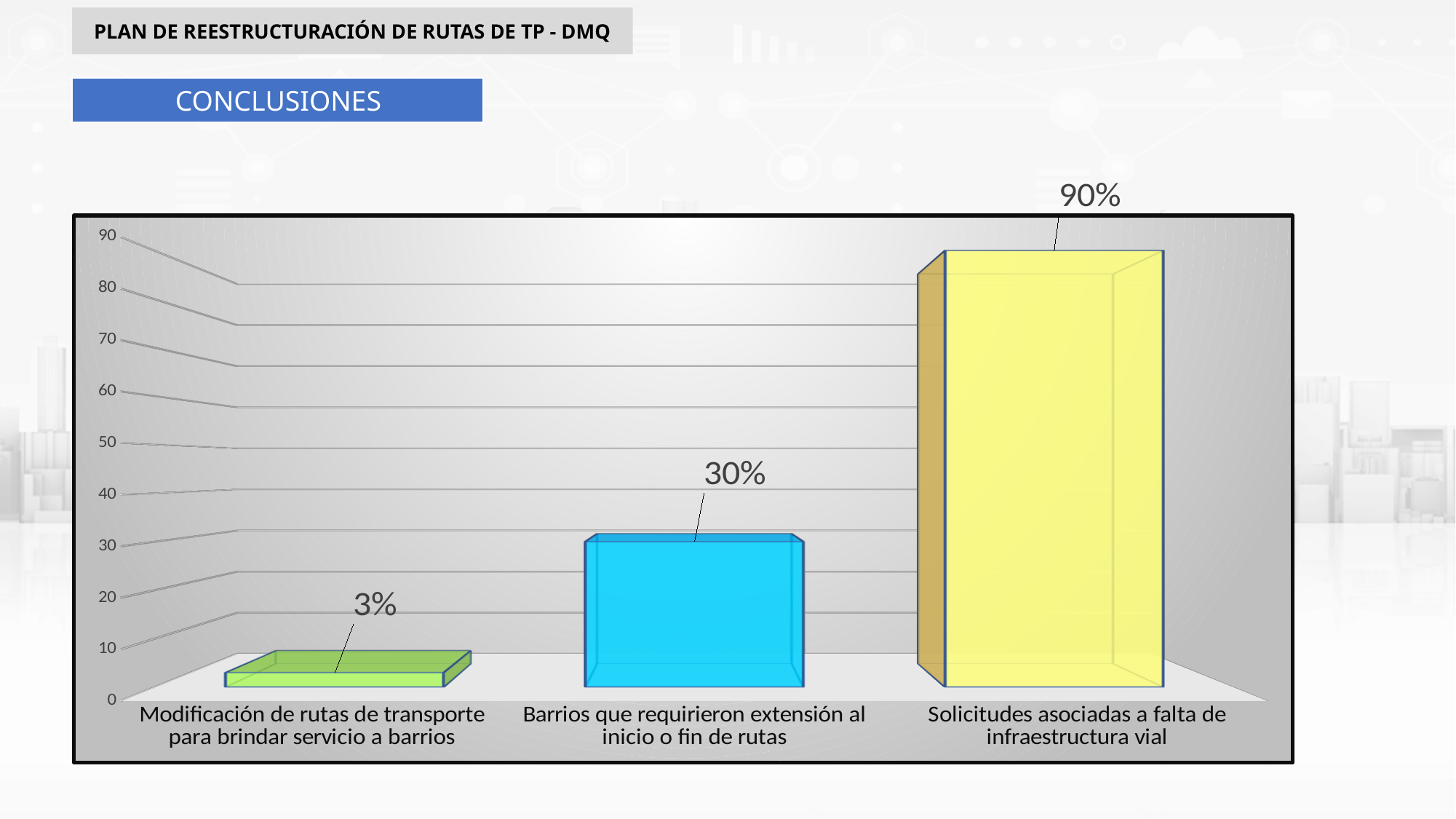
What is the difference between the values for "Solicitudes asociadas a falta de infraestructura vial" and "Barrios que requirieron extensión al inicio o fin de rutas"? 60% What is the difference between the values for "Barrios que requirieron extensión al inicio o fin de rutas" and "Modificación de rutas de transporte para brindar servicio a barrios"? 27% How many categories are shown in the chart? 3 What colour is the bar for "Solicitudes asociadas a falta de infraestructura vial"? Yellow What is the value for "Modificación de rutas de transporte para brindar servicio a barrios"? 3% Is the value for "Solicitudes asociadas a falta de infraestructura vial" greater or less than 50? greater What is the value for "Solicitudes asociadas a falta de infraestructura vial"? 90% Which category has the highest value? Solicitudes asociadas a falta de infraestructura vial What is the value for "Barrios que requirieron extensión al inicio o fin de rutas"? 30% Which category has the lowest value? Modificación de rutas de transporte para brindar servicio a barrios Which is larger: the value for "Barrios que requirieron extensión al inicio o fin de rutas" or for "Modificación de rutas de transporte para brindar servicio a barrios"? Barrios que requirieron extensión al inicio o fin de rutas What kind of chart is shown on the slide? Bar chart